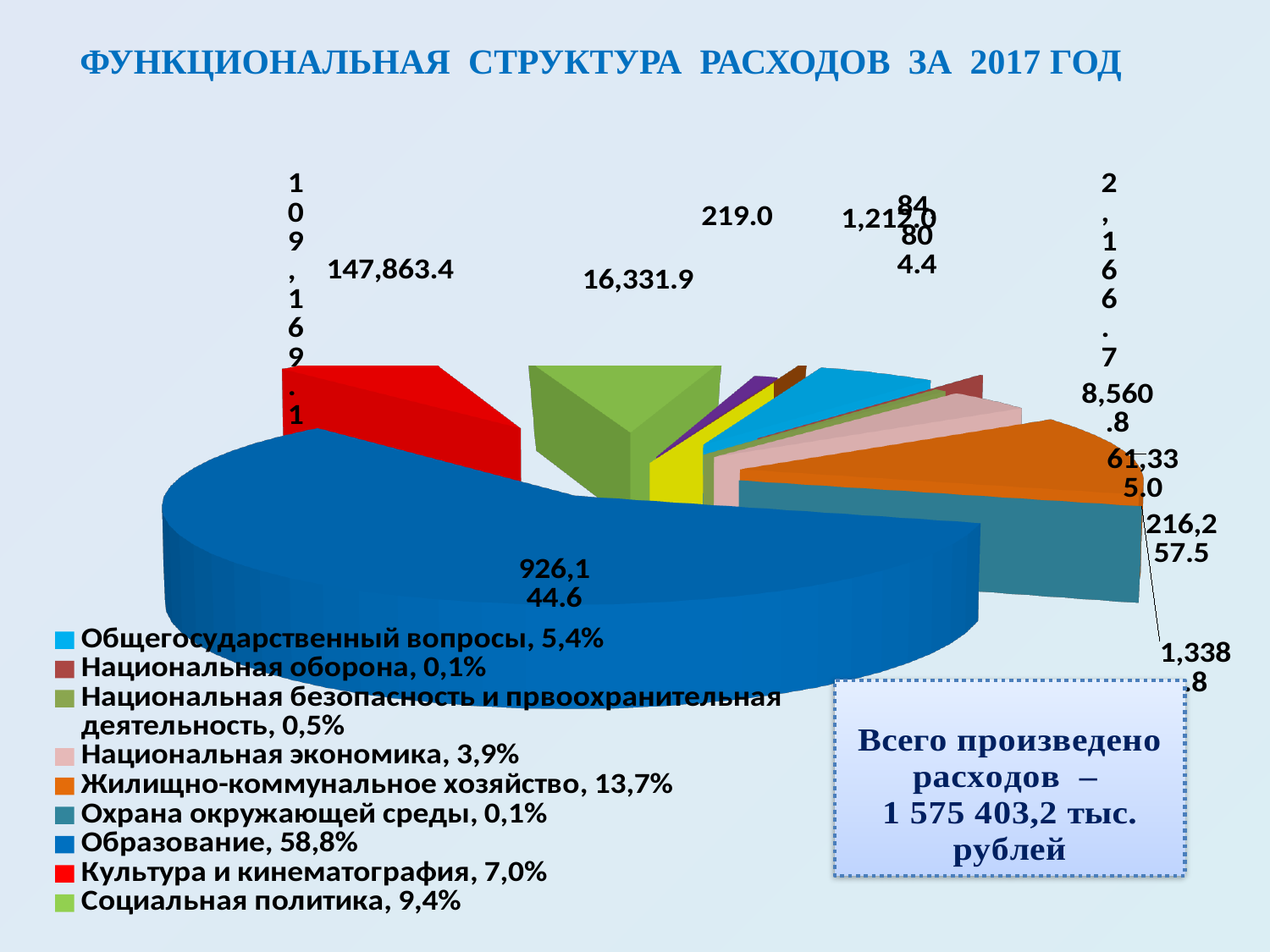
Which has a larger share: Жилищно-коммунальное хозяйство or Социальная политика? Жилищно-коммунальное хозяйство What percentage is shown for Социальная политика in the legend? 9,4% What value is labelled on the Образование (blue) slice? 926,144.6 Which category has the largest share of expenditures? Образование What is the title of the chart? ФУНКЦИОНАЛЬНАЯ СТРУКТУРА РАСХОДОВ ЗА 2017 ГОД What share of expenditures does Жилищно-коммунальное хозяйство account for? 13,7% What kind of chart is shown on the slide? pie chart What share of expenditures does Образование account for? 58,8% What is the difference in share between Жилищно-коммунальное хозяйство (13,7%) and Социальная политика (9,4%)? 4,3% According to the text box on the slide, what is the total amount of expenditures? 1 575 403,2 тыс. рублей How many categories does the legend list? 9 What percentage is shown for Культура и кинематография in the legend? 7,0%